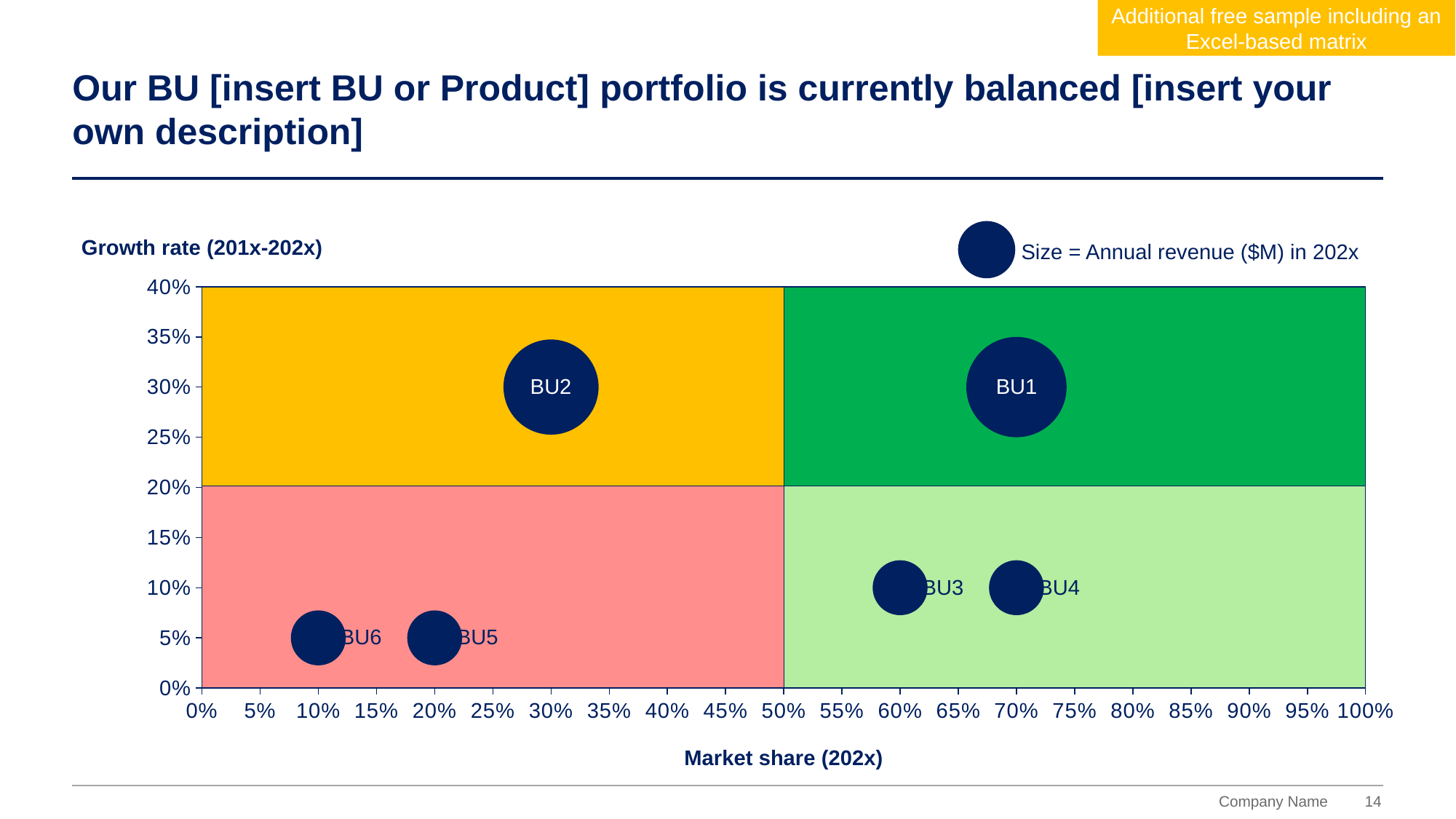
Is the market share of BU2 greater or less than 50%? less What is the market share of BU3? 60% What is the market share of BU1? 70% Which business unit has the lowest market share? BU6 What is the growth rate of BU5? 5% What is the difference in growth rate between BU1 and BU4? 20 percentage points What does the size of each bubble represent? Annual revenue ($M) in 202x What kind of chart is shown on the slide? Bubble chart What is the label of the horizontal axis? Market share (202x) What is the growth rate of BU2? 30% Which has the larger market share, BU1 or BU3? BU1 How many business units (bubbles) are plotted on the chart? 6